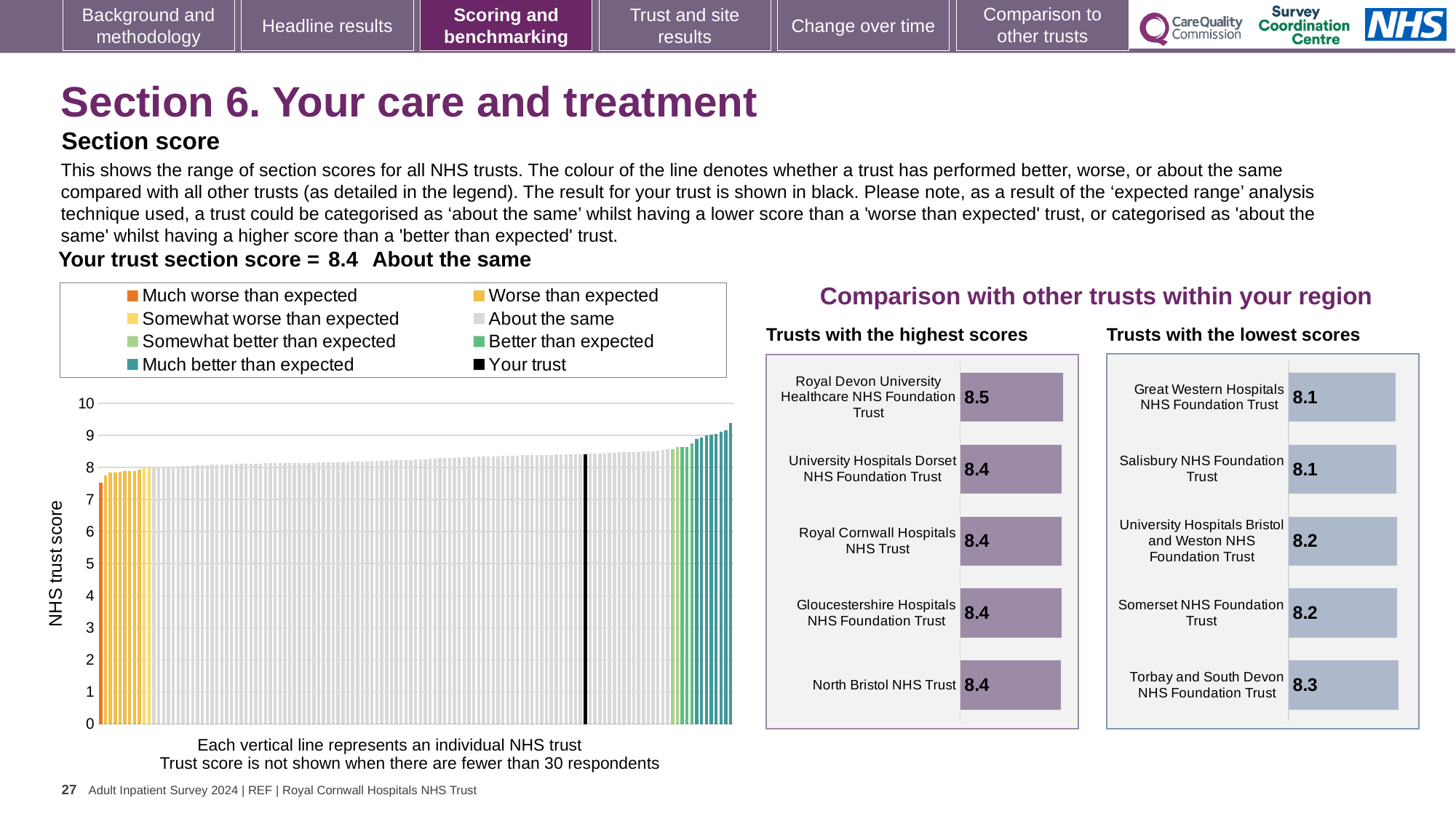
In the 'Trusts with the highest scores' chart, what is the difference between the scores of Royal Devon University Healthcare NHS Foundation Trust and North Bristol NHS Trust? 0.1 In the main chart of NHS trust scores on the left, do the trust scores rise or fall from left to right? Rise In the main chart of NHS trust scores on the left, how many entries does the legend list? 8 Which is larger: the score for Royal Devon University Healthcare NHS Foundation Trust in the highest scores chart, or the score for Great Western Hospitals NHS Foundation Trust in the lowest scores chart? Royal Devon University Healthcare NHS Foundation Trust In the 'Trusts with the lowest scores' chart, what is the difference between the scores of Torbay and South Devon NHS Foundation Trust and Great Western Hospitals NHS Foundation Trust? 0.2 In the 'Trusts with the lowest scores' chart, which trust has the highest score? Torbay and South Devon NHS Foundation Trust How many trusts are shown in the 'Trusts with the lowest scores' chart? 5 In the 'Trusts with the highest scores' chart, which trust has the highest score? Royal Devon University Healthcare NHS Foundation Trust In the main chart of NHS trust scores on the left, what colour is used for 'Your trust'? Black What kind of chart is the 'Trusts with the highest scores' chart? Bar chart In the 'Trusts with the highest scores' chart, what is the score for Royal Devon University Healthcare NHS Foundation Trust? 8.5 In the 'Trusts with the lowest scores' chart, what is the score for Somerset NHS Foundation Trust? 8.2